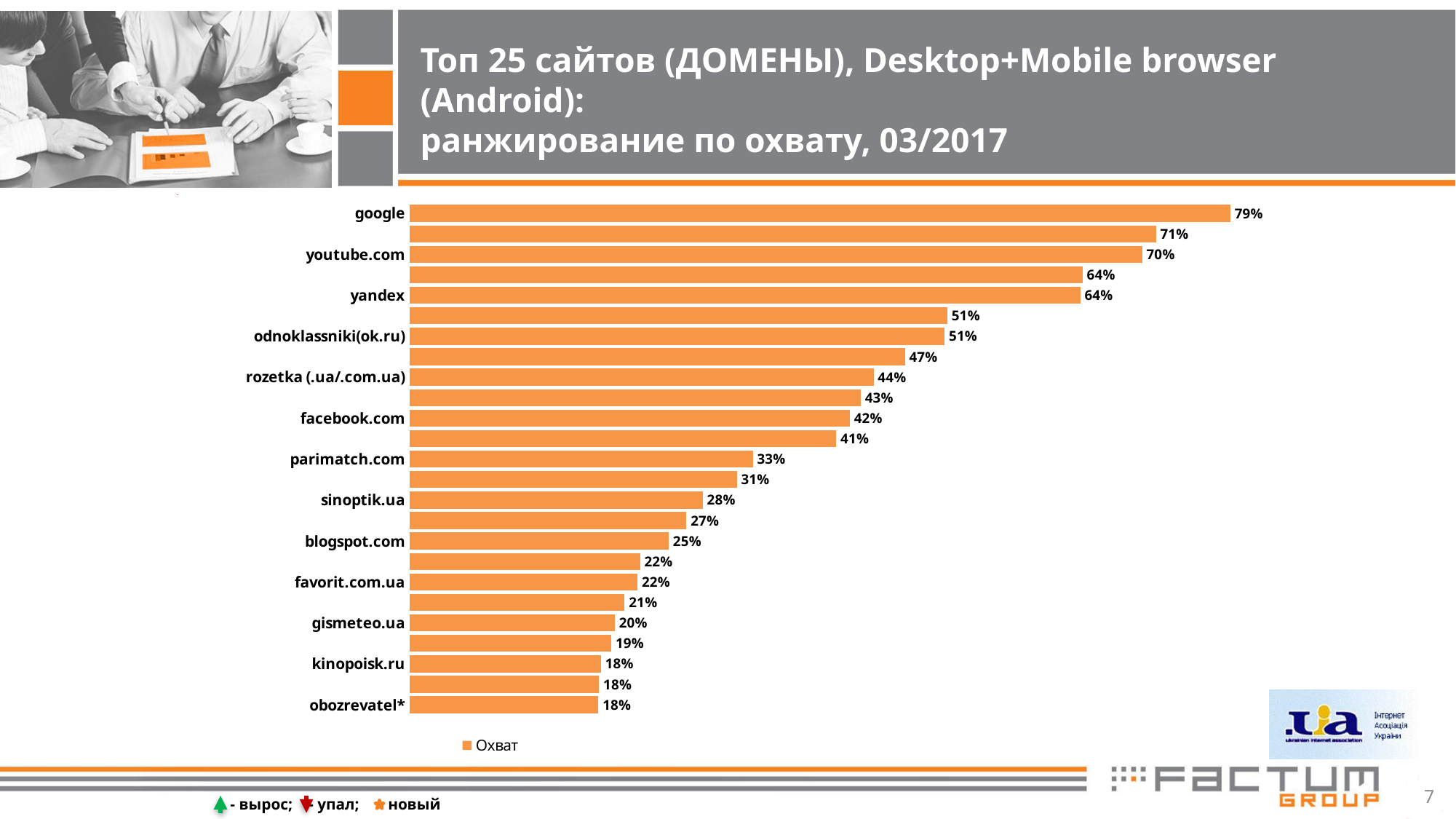
What is the difference between the values for google and youtube.com? 9% How many bars are plotted in the chart? 25 What is the value for gismeteo.ua? 20% What is the name of the series shown in the legend? Охват What kind of chart is shown? bar chart What is the value for odnoklassniki(ok.ru)? 51% Which has a larger value, yandex or facebook.com? yandex What is the value for facebook.com? 42% What is the value for sinoptik.ua? 28% What is the value for google? 79% Which site has the highest value? google What is the value for youtube.com? 70%